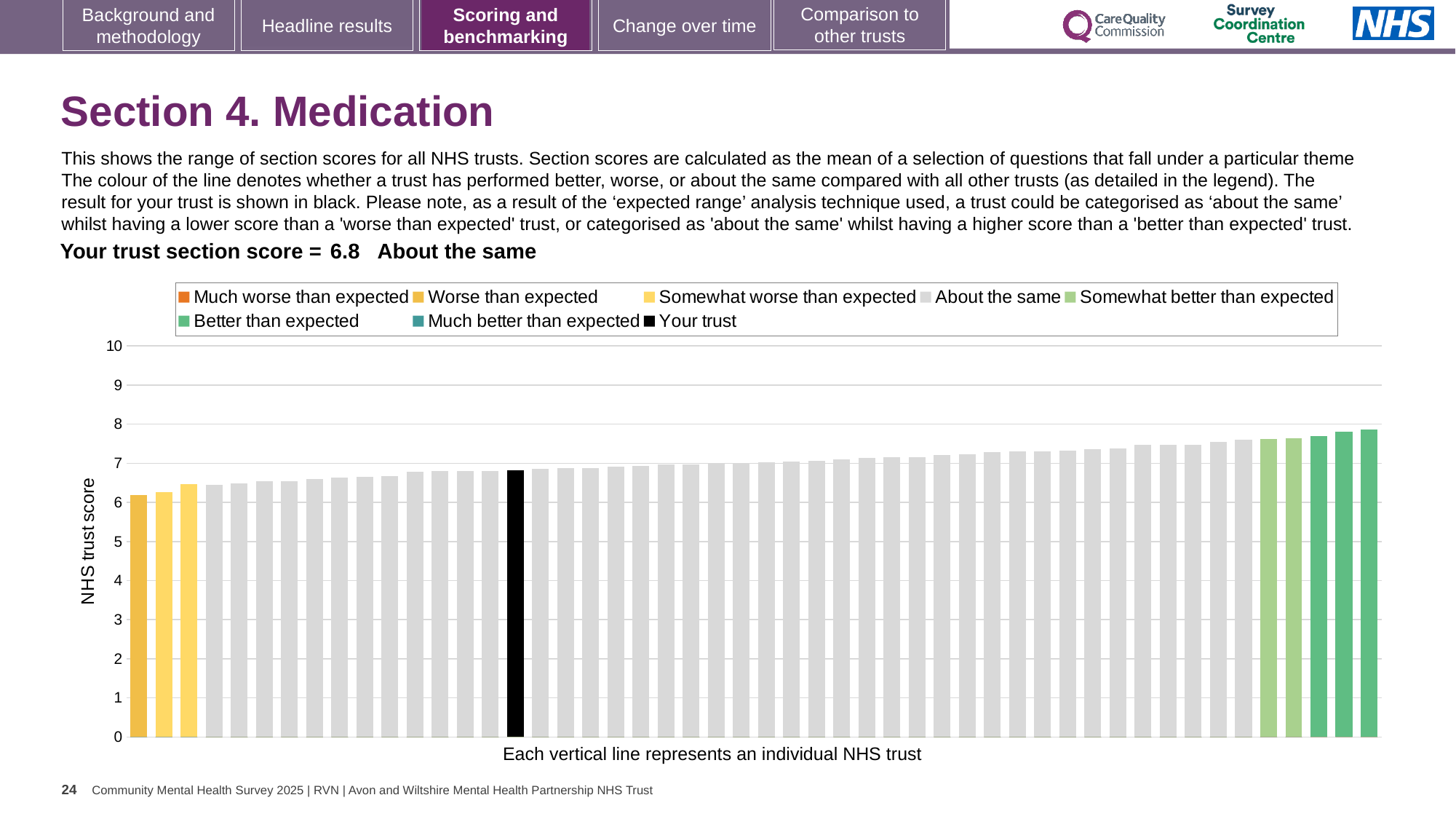
What colour is the bar representing your trust? black Is the value of the tallest bar greater or less than 7? greater Is the value of your trust's bar greater or less than 7? less Is the value of the shortest bar greater or less than 6? greater What is the label on the vertical axis of the chart? NHS trust score How many entries does the chart legend list? 8 What kind of chart is shown on the slide? bar chart Which category is your trust's section score placed in? About the same What is the section score for your trust shown on the slide? 6.8 Do the bar values rise or fall from left to right along the x axis? rise How many bars are coloured as 'Worse than expected' (yellow) in the chart? 1